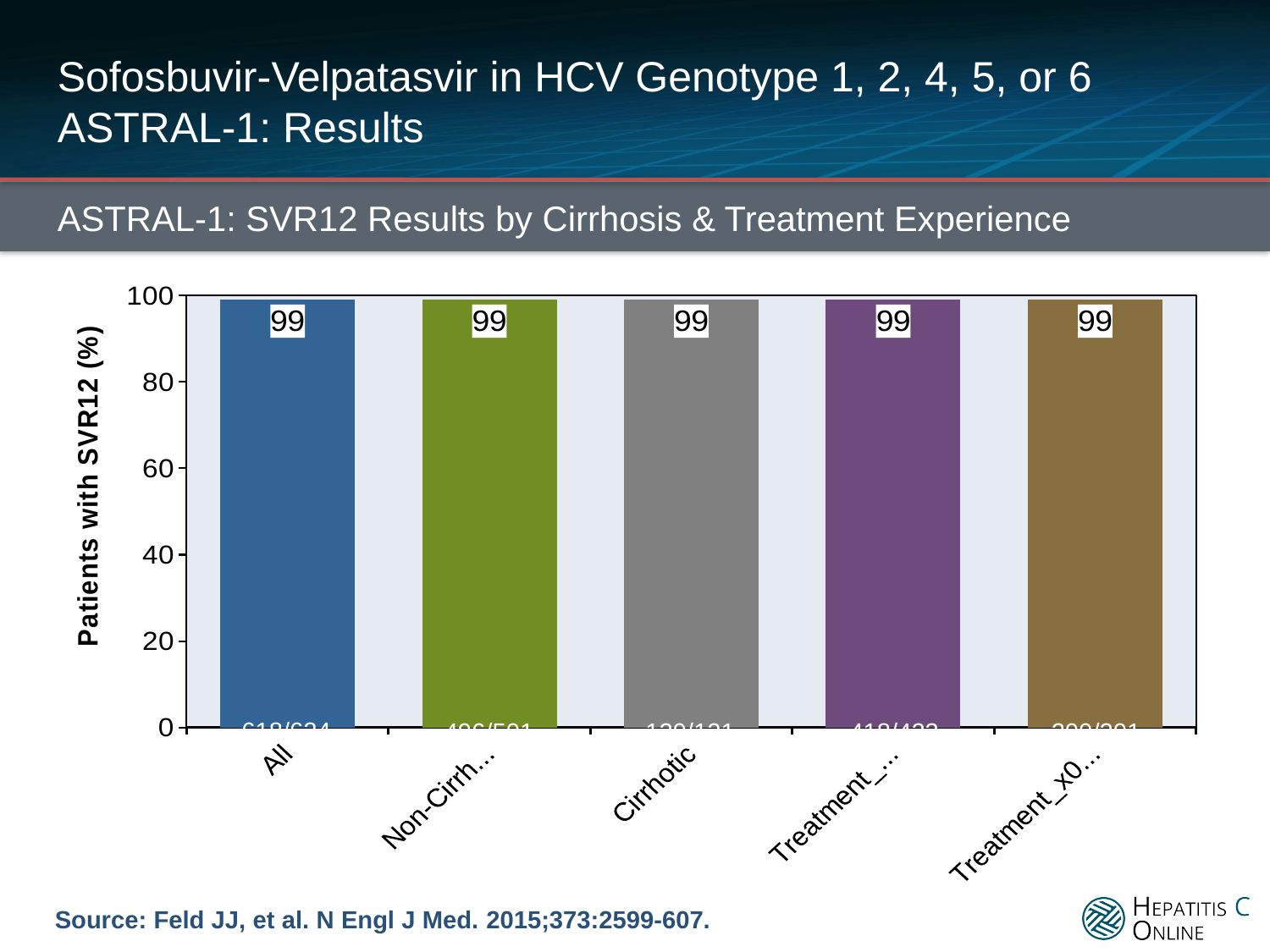
Do the bar values rise, fall, or stay flat from left to right across the categories? stay flat What is the value for the Cirrhotic category? 99 What is the value for the All category? 99 What is the difference between the values for All and Cirrhotic? 0 What is the label on the vertical axis? Patients with SVR12 (%) Is the value for All greater or less than 60? greater What is the title of the chart? ASTRAL-1: SVR12 Results by Cirrhosis & Treatment Experience What kind of chart is shown on the slide? bar chart How many bars are plotted in the chart? 5 Is the value for Cirrhotic greater or less than 80? greater